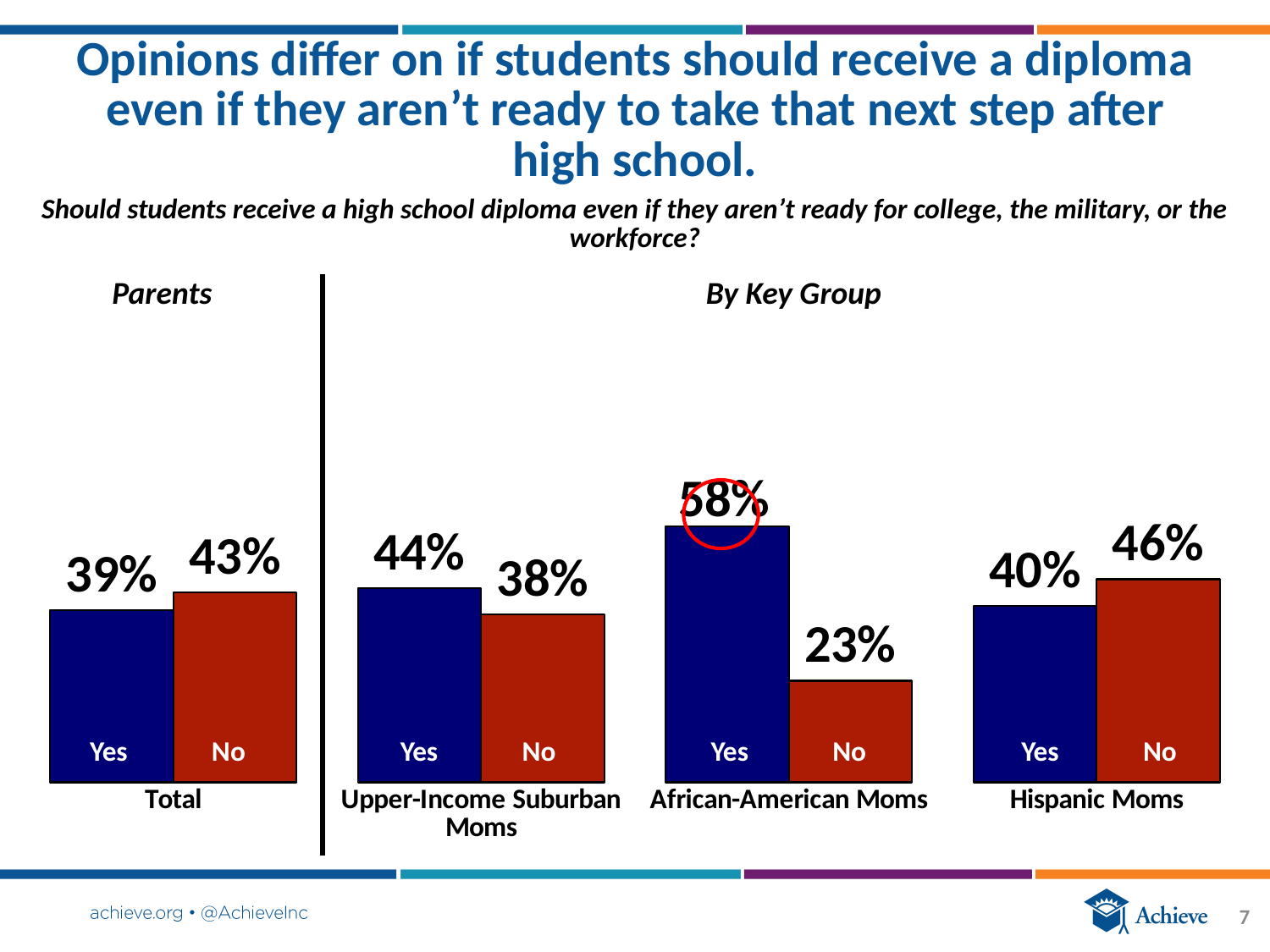
In the By Key Group chart, is the Yes value for Hispanic Moms larger or smaller than the No value for Hispanic Moms? smaller In the By Key Group chart, what is the Yes value for African-American Moms? 58% How many groups are shown in the By Key Group chart? 3 In the By Key Group chart, what is the difference between the Yes and No values for African-American Moms? 35% In the Parents chart, what percentage of the Total answered No? 43% In the Parents chart, what is the difference between the No and Yes values for the Total? 4% In the By Key Group chart, what is the No value for Hispanic Moms? 46% In the By Key Group chart, which group has the highest Yes value? African-American Moms In the Parents chart, what percentage of the Total answered Yes? 39% In the By Key Group chart, what is the No value for Upper-Income Suburban Moms? 38% In the By Key Group chart, which group has the lowest No value? African-American Moms What type of chart is used in the By Key Group section? bar chart